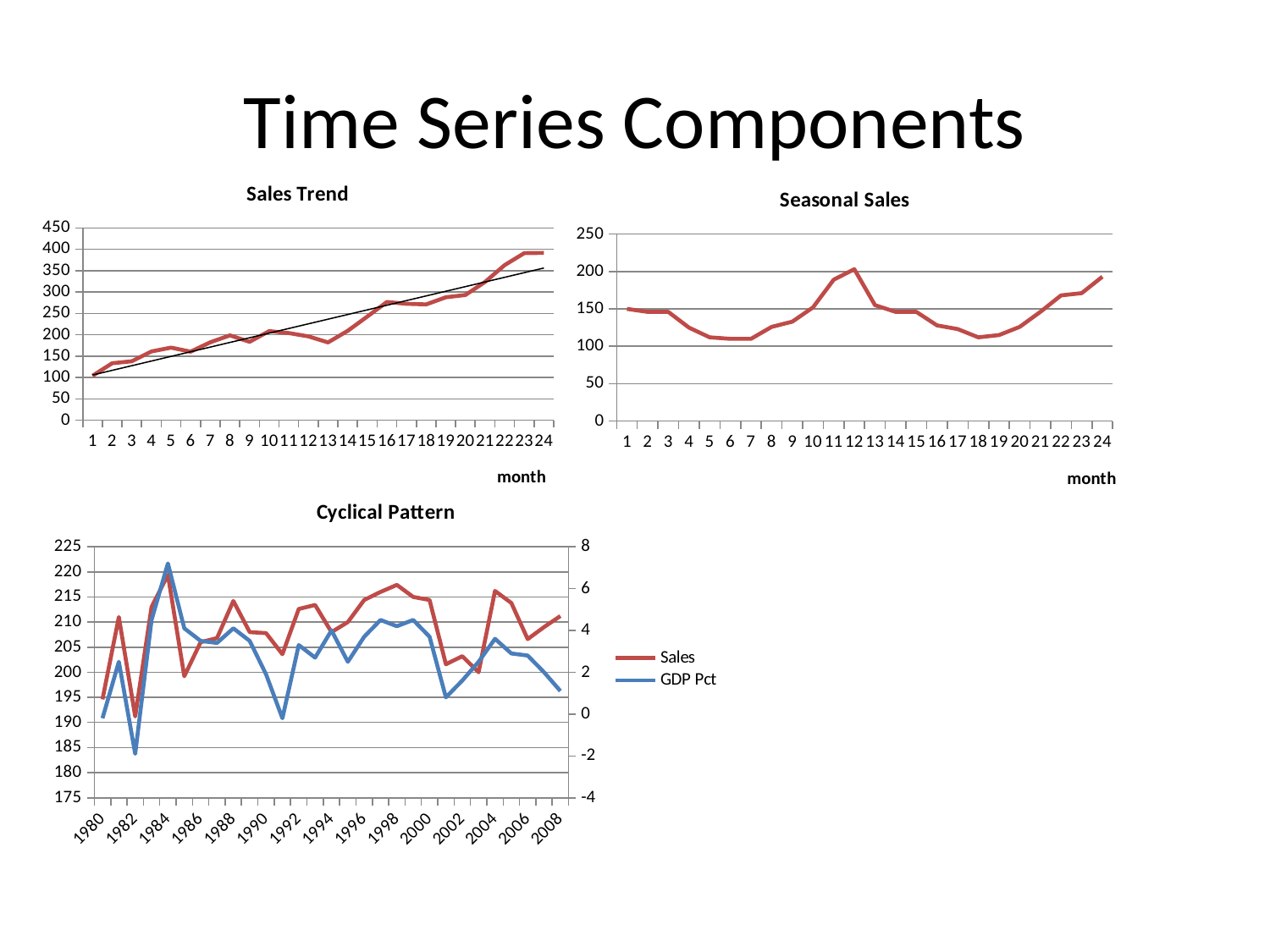
What kind of chart is the Sales Trend chart? line chart In the Cyclical Pattern chart, is the GDP Pct value for 1982 greater or less than 0? less In the Cyclical Pattern chart, in which year does GDP Pct reach its highest value? 1984 In the Seasonal Sales chart, is the value for month 18 greater or less than 150? less What are the two series named in the legend of the Cyclical Pattern chart? Sales and GDP Pct How many series does the legend of the Cyclical Pattern chart list? 2 In the Sales Trend chart, do the values generally rise or fall from month 1 to month 24? rise In the Sales Trend chart, is the value for month 1 greater or less than 150? less How many months are plotted on the x axis of the Seasonal Sales chart? 24 In the Cyclical Pattern chart, in which year does GDP Pct reach its lowest value? 1982 In the Seasonal Sales chart, which month has the highest value? 12